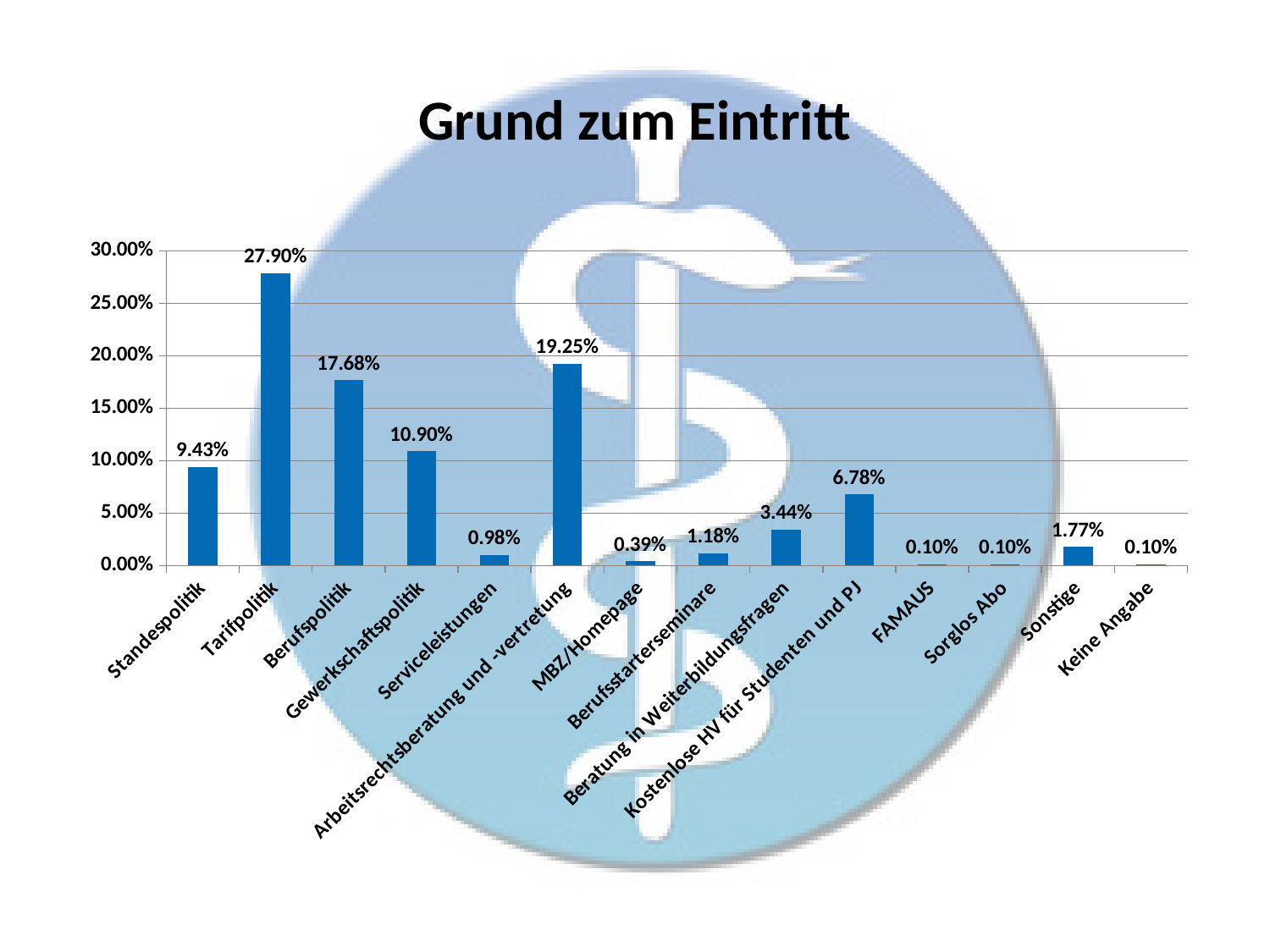
What kind of chart is shown on the slide? bar chart What is the value for Beratung in Weiterbildungsfragen? 3.44% Which category has the highest value? Tarifpolitik Which is larger, the value for Standespolitik or the value for Gewerkschaftspolitik? Gewerkschaftspolitik What is the value for Arbeitsrechtsberatung und -vertretung? 19.25% What is the title of the chart? Grund zum Eintritt What is the difference between the values for Berufspolitik and Gewerkschaftspolitik? 6.78% How many categories are shown on the x axis? 14 What is the value for Kostenlose HV für Studenten und PJ? 6.78% What is the value for Tarifpolitik? 27.90% Is the value for Berufspolitik greater or less than 15.00%? greater What is the difference between the values for Tarifpolitik and Arbeitsrechtsberatung und -vertretung? 8.65%